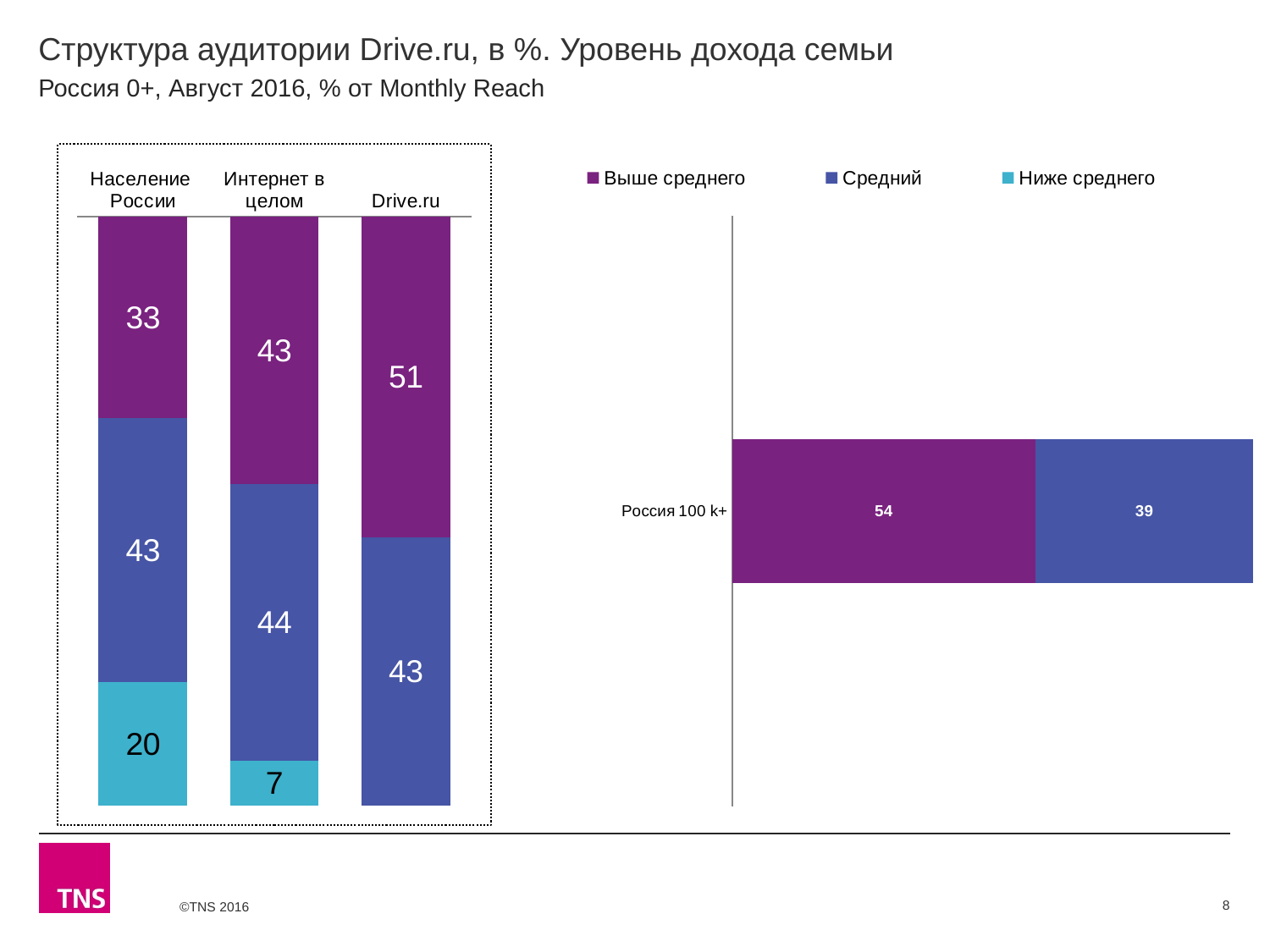
In the left stacked bar chart, which category has the highest 'Выше среднего' value? Drive.ru In the right chart, what is the 'Выше среднего' value for 'Россия 100 k+'? 54 How many series does the legend list? 3 In the left stacked bar chart, which category has the lowest 'Ниже среднего' value among those with a labelled segment? Интернет в целом What kind of chart is the chart on the right of the slide? Stacked bar chart In the left stacked bar chart, what is the difference between the 'Выше среднего' values for Drive.ru and 'Население России'? 18 In the right chart, what is the total of the two labelled segments for 'Россия 100 k+'? 93 In the left stacked bar chart, is the 'Выше среднего' value larger for 'Интернет в целом' or for 'Население России'? Интернет в целом In the left stacked bar chart, what is the value of the 'Ниже среднего' segment for 'Население России'? 20 In the left stacked bar chart, what is the value of the 'Выше среднего' segment for Drive.ru? 51 In the left stacked bar chart, what is the value of the 'Средний' segment for 'Интернет в целом'? 44 How many categories are shown in the left stacked bar chart? 3